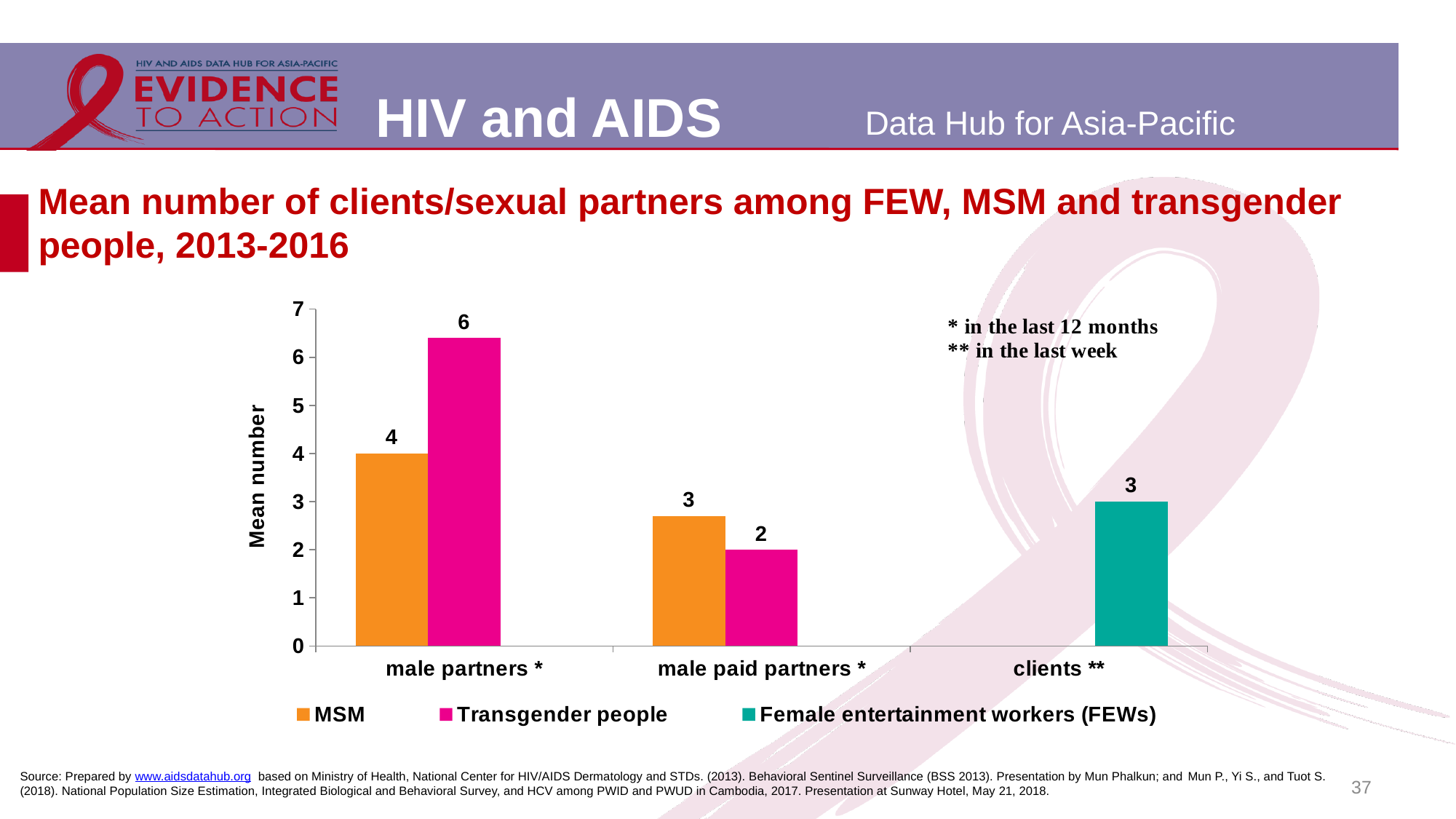
What is the mean number of male paid partners for MSM? 3 How many categories are shown on the x axis? 3 How many series does the legend list? 3 What kind of chart is shown on the slide? bar chart What is the mean number of male partners for transgender people? 6 For male partners, which group has the larger mean number, MSM or transgender people? Transgender people Is the mean number of male partners for transgender people greater or less than 5? greater Which series has the highest bar in the chart? Transgender people What is the mean number of clients for female entertainment workers (FEWs)? 3 What is the difference between the mean number of male partners for transgender people and for MSM? 2 What is the mean number of male partners for MSM? 4 What is the mean number of male paid partners for transgender people? 2